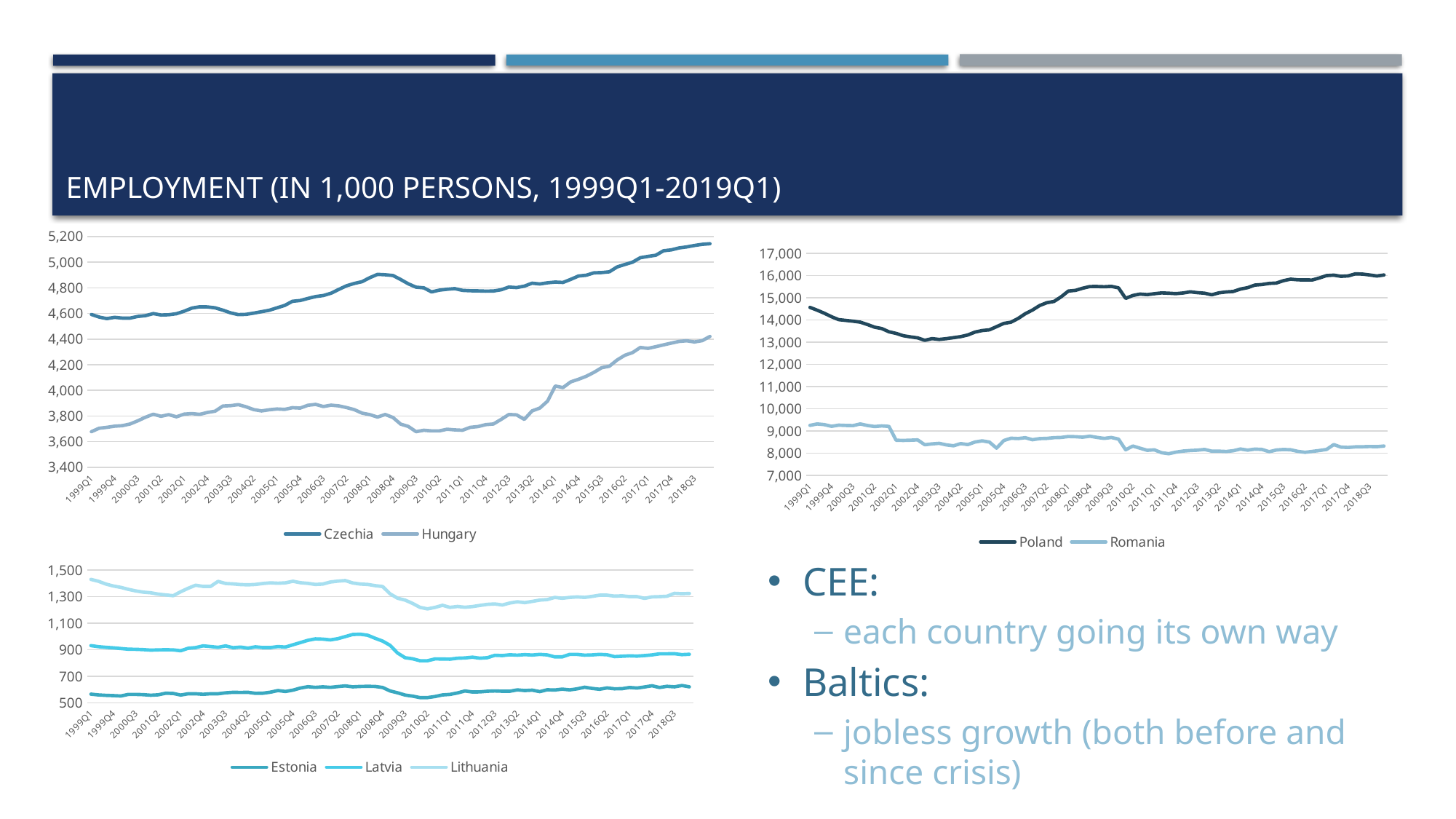
In the top-right chart, is the value for Poland at 2003Q3 greater or less than 14,000? less In the top-left chart, is the value for Hungary at 2010Q2 greater or less than 3,800? less What kind of chart is the top-left chart showing Czechia and Hungary? line chart In the top-right chart, does the Romania series overall rise or fall from 1999Q1 to 2018Q3? fall In the bottom-left chart, is the value for Latvia at 2008Q1 greater or less than 900? greater What is the title of the slide containing the charts? EMPLOYMENT (IN 1,000 PERSONS, 1999Q1-2019Q1) How many series does the legend of the top-right chart (Poland and Romania) list? 2 How many series does the legend of the bottom-left chart (Estonia, Latvia, Lithuania) list? 3 In the top-left chart, which series has higher values throughout the period, Czechia or Hungary? Czechia In the bottom-left chart, which country has the lowest employment values throughout the period? Estonia